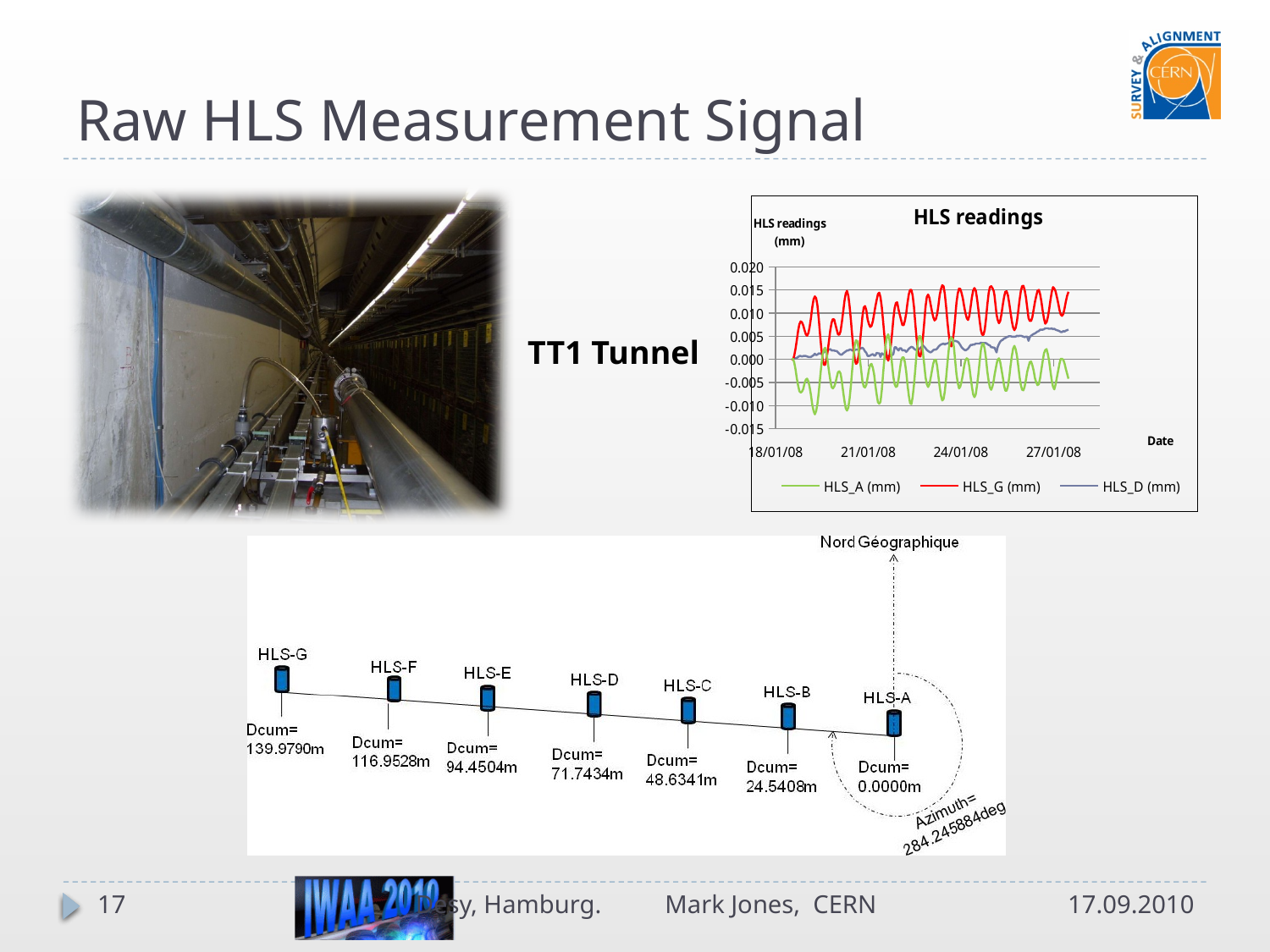
In the "HLS readings" chart, which series has the lowest readings overall? HLS_A (mm) What kind of chart is the "HLS readings" chart? line chart In the "HLS readings" chart, are the values of HLS_D (mm) greater or less than 0.010 throughout? less In the "HLS readings" chart, which series has the highest readings overall? HLS_G (mm) How many series does the legend of the "HLS readings" chart list? 3 What is the title of the chart on the slide? HLS readings In the "HLS readings" chart, are the peak values of HLS_G (mm) greater or less than 0.010? greater In the "HLS readings" chart, are the values of HLS_A (mm) greater or less than 0.010 throughout? less In the "HLS readings" chart, does the HLS_D (mm) series rise or fall over the period shown? rise In the "HLS readings" chart, what colour is the HLS_G (mm) series drawn in? red In the "HLS readings" chart, which series has larger values, HLS_G (mm) or HLS_A (mm)? HLS_G (mm) How many date labels are shown on the x axis of the "HLS readings" chart? 4